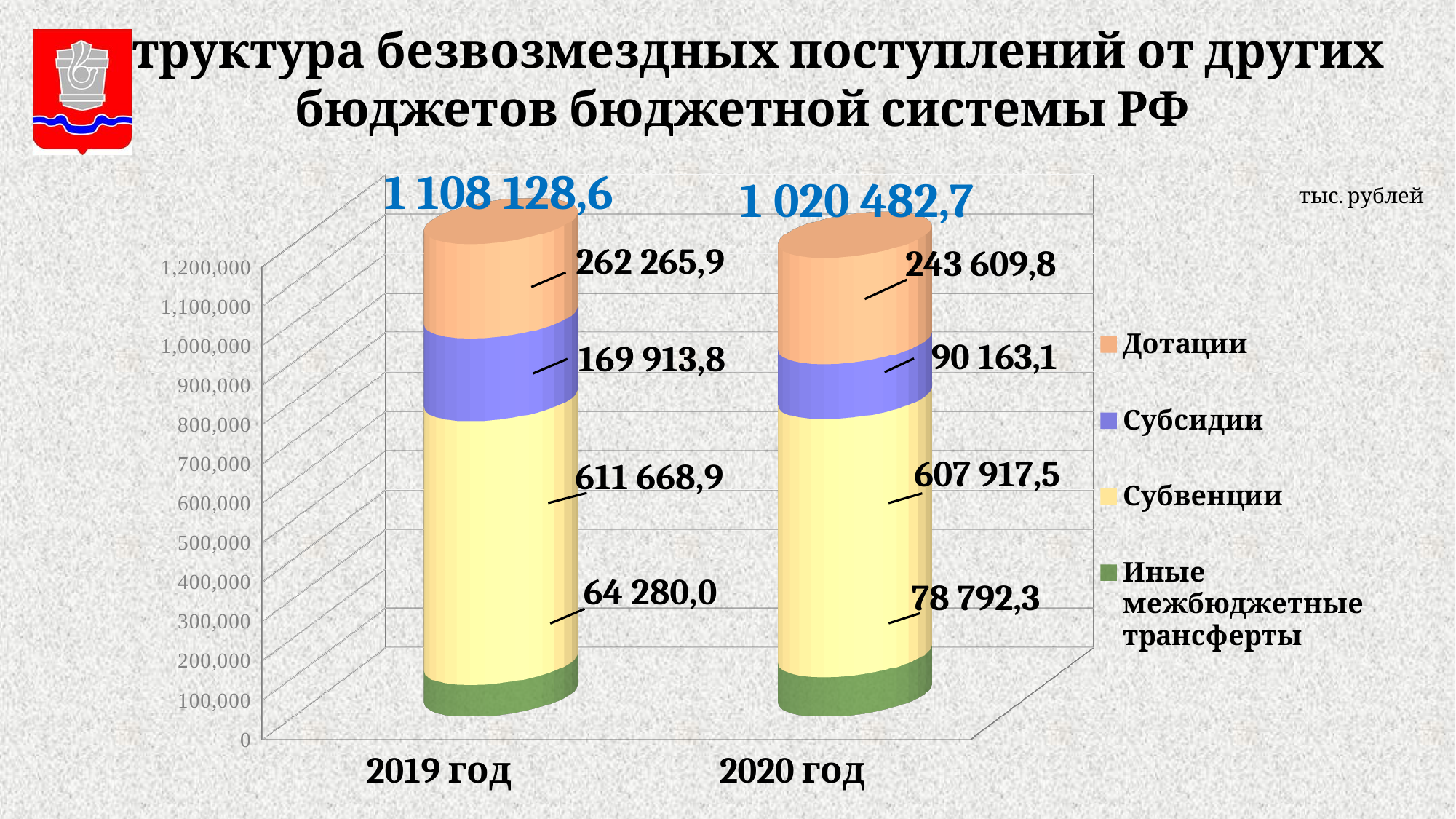
What is the value of Дотации for 2020 год? 243 609,8 Is the total for 2019 год or 2020 год larger? 2019 год What is the total of the stacked bar for 2020 год? 1 020 482,7 What is the value of Субсидии for 2020 год? 90 163,1 Which series has the largest value in 2019 год? Субвенции What is the value of Иные межбюджетные трансферты for 2019 год? 64 280,0 Which series has the smallest value in 2020 год? Иные межбюджетные трансферты How many categories (years) are shown on the x axis? 2 By how much did Субсидии decrease from 2019 год to 2020 год? 79 750,7 What is the value of Субвенции for 2019 год? 611 668,9 What type of chart is shown on the slide? stacked bar chart How many series does the legend list? 4